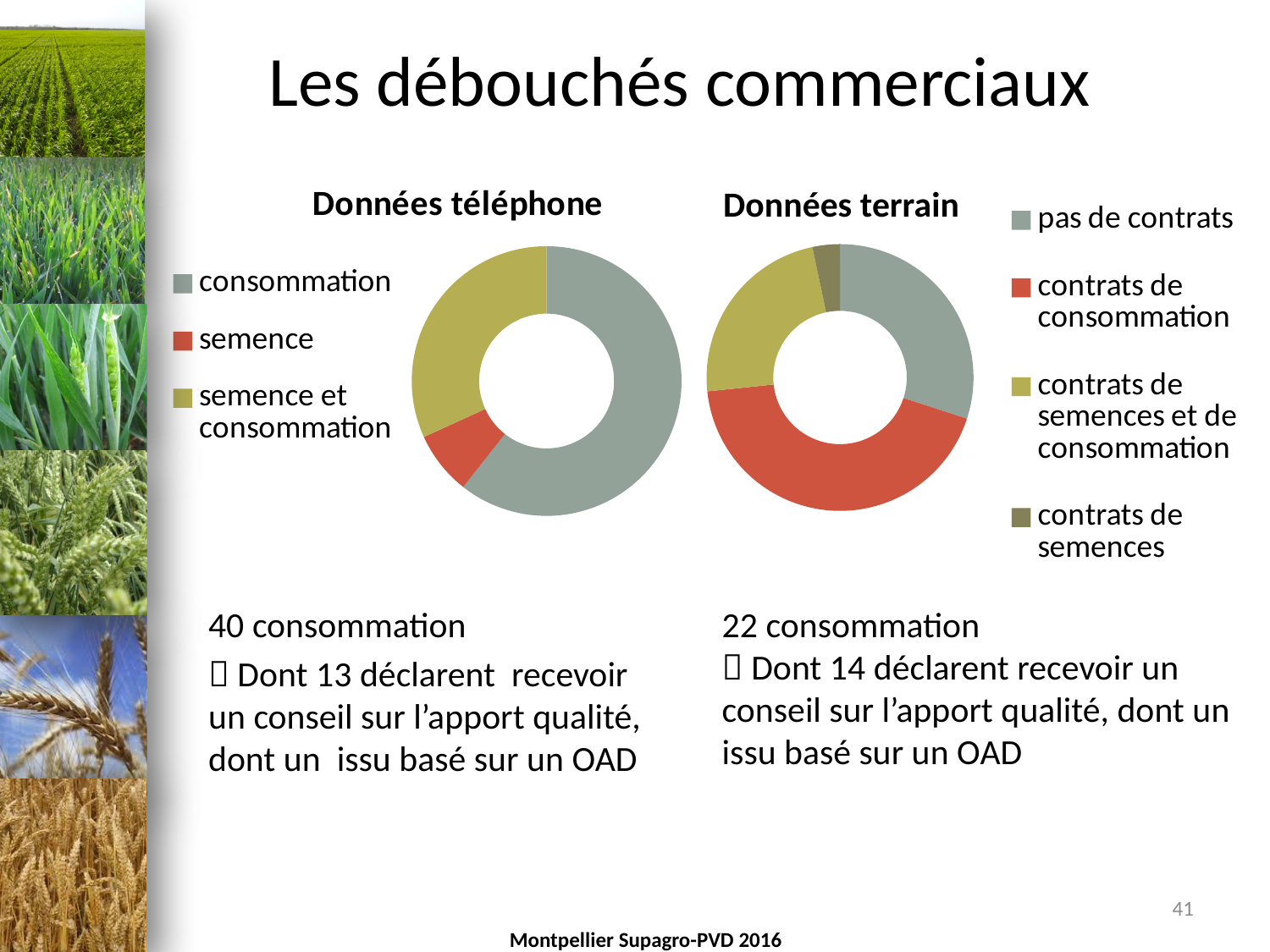
In the 'Données terrain' chart, which is larger: 'contrats de consommation' or 'contrats de semences'? contrats de consommation How many categories does the legend of the 'Données terrain' chart list? 4 In the 'Données téléphone' chart, which category has the smallest share? semence What kind of chart is the 'Données terrain' chart? doughnut chart In the 'Données terrain' chart, which category has the smallest share? contrats de semences What kind of chart is the 'Données téléphone' chart? doughnut chart What is the title of the chart on the left? Données téléphone In the 'Données terrain' chart, which is larger: 'contrats de semences et de consommation' or 'contrats de semences'? contrats de semences et de consommation What colour represents 'pas de contrats' in the 'Données terrain' chart? grey In the 'Données téléphone' chart, which is larger: 'semence' or 'semence et consommation'? semence et consommation In the 'Données téléphone' chart, which category has the largest share? consommation How many categories does the legend of the 'Données téléphone' chart list? 3